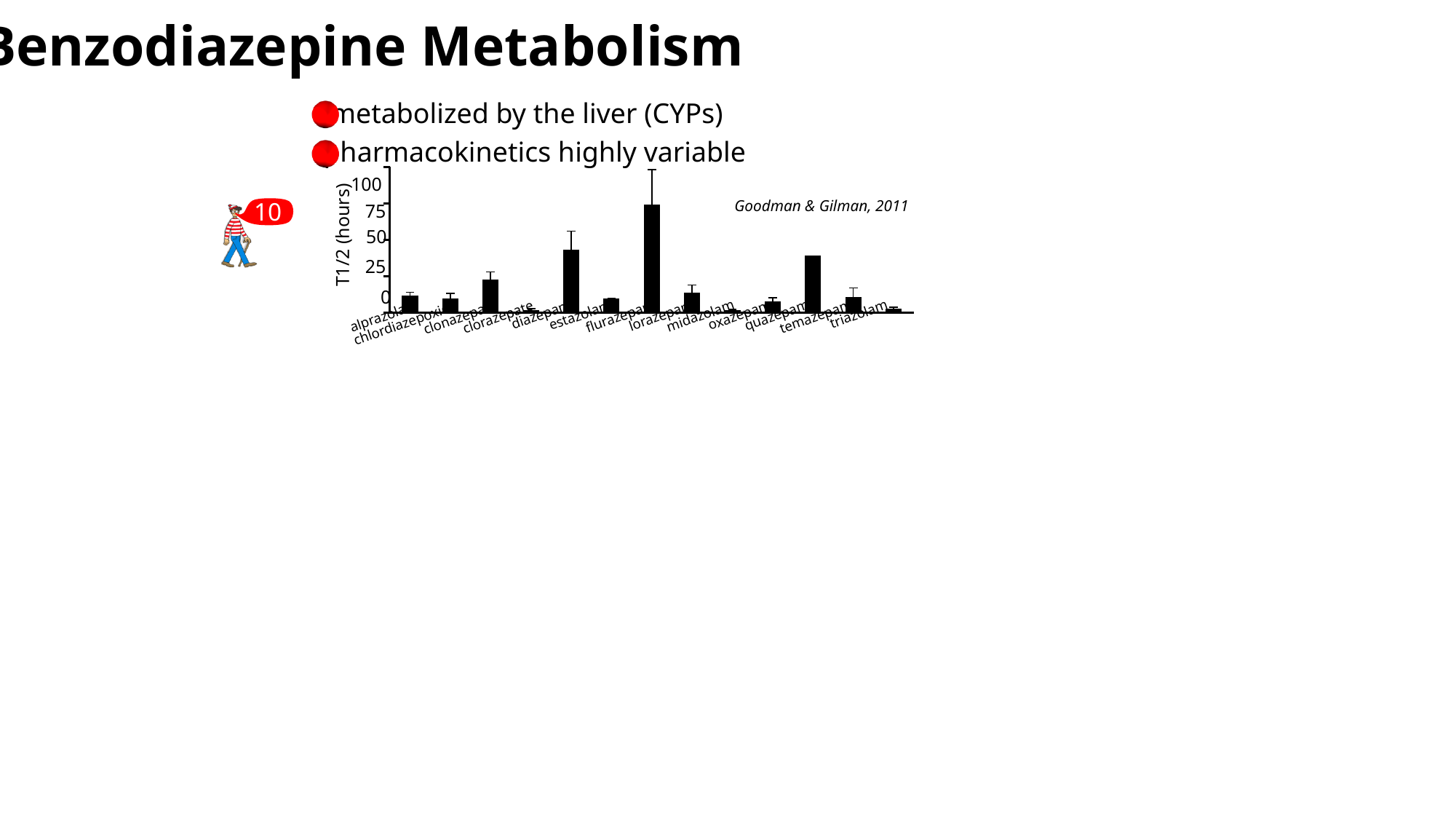
Which has a larger T1/2 value, clonazepam or lorazepam? clonazepam Which drug has the highest T1/2 (hours) value in the chart? flurazepam Which has a larger T1/2 value, flurazepam or diazepam? flurazepam What is the label on the y axis of the chart? T1/2 (hours) Is the T1/2 value for flurazepam greater or less than 50 hours? greater Is the T1/2 value for diazepam greater or less than 25 hours? greater What kind of chart is shown on the slide? bar chart Is the T1/2 value for lorazepam greater or less than 25 hours? less How many drugs (categories) are plotted on the x axis of the chart? 13 What source is cited next to the chart? Goodman & Gilman, 2011